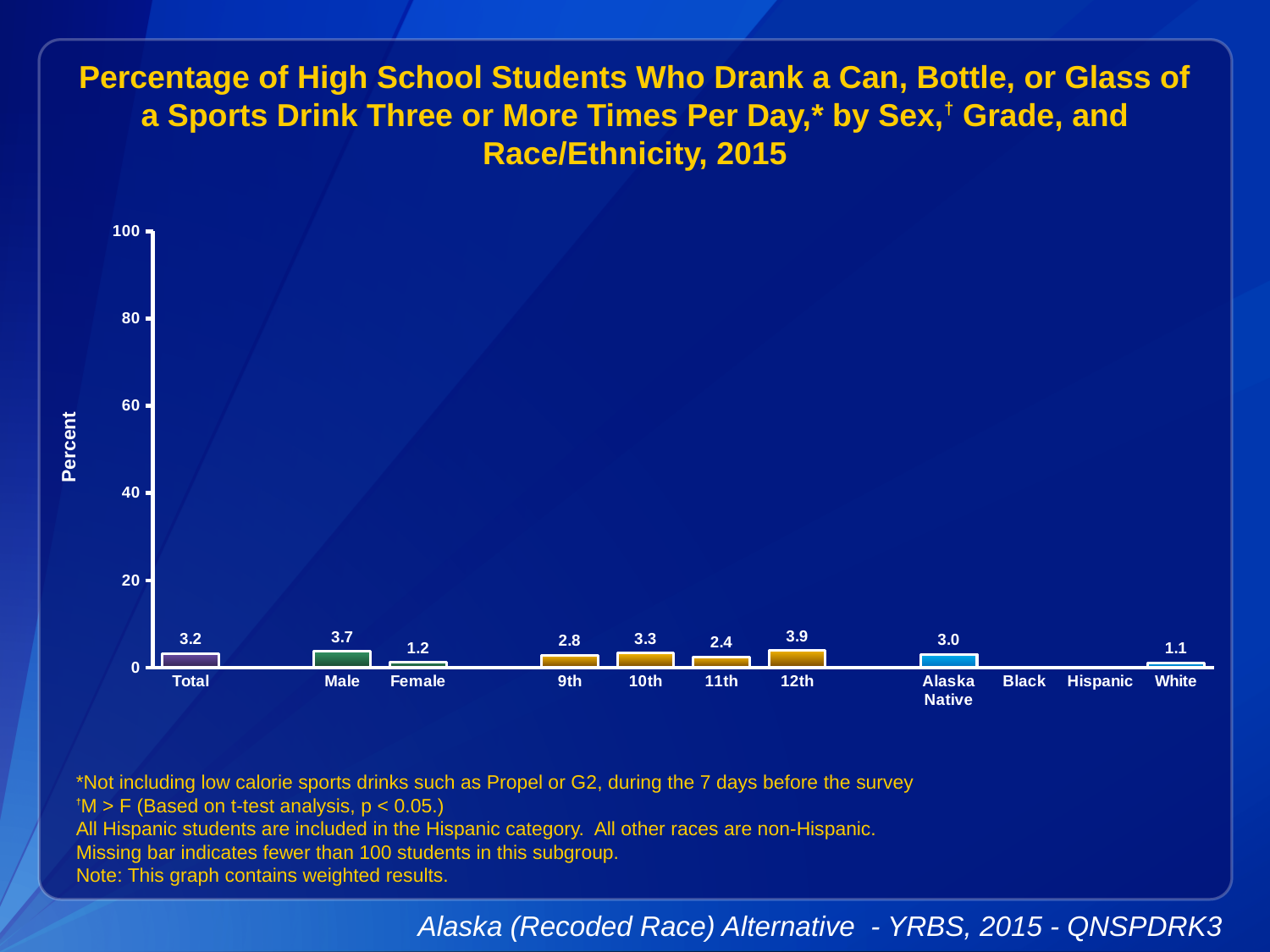
What is the value for Total? 3.2 Is the value for 10th grade greater or less than 20? less What is the label on the y axis? Percent Which is larger, the value for 9th grade or 11th grade? 9th What is the value for Alaska Native? 3.0 Which grade has the highest value? 12th What is the difference between the Male and Female values? 2.5 What is the value for 12th grade? 3.9 What is the value for Female? 1.2 Which category with a plotted bar has the lowest value? White What kind of chart is shown on the slide? bar chart What is the value for Male? 3.7